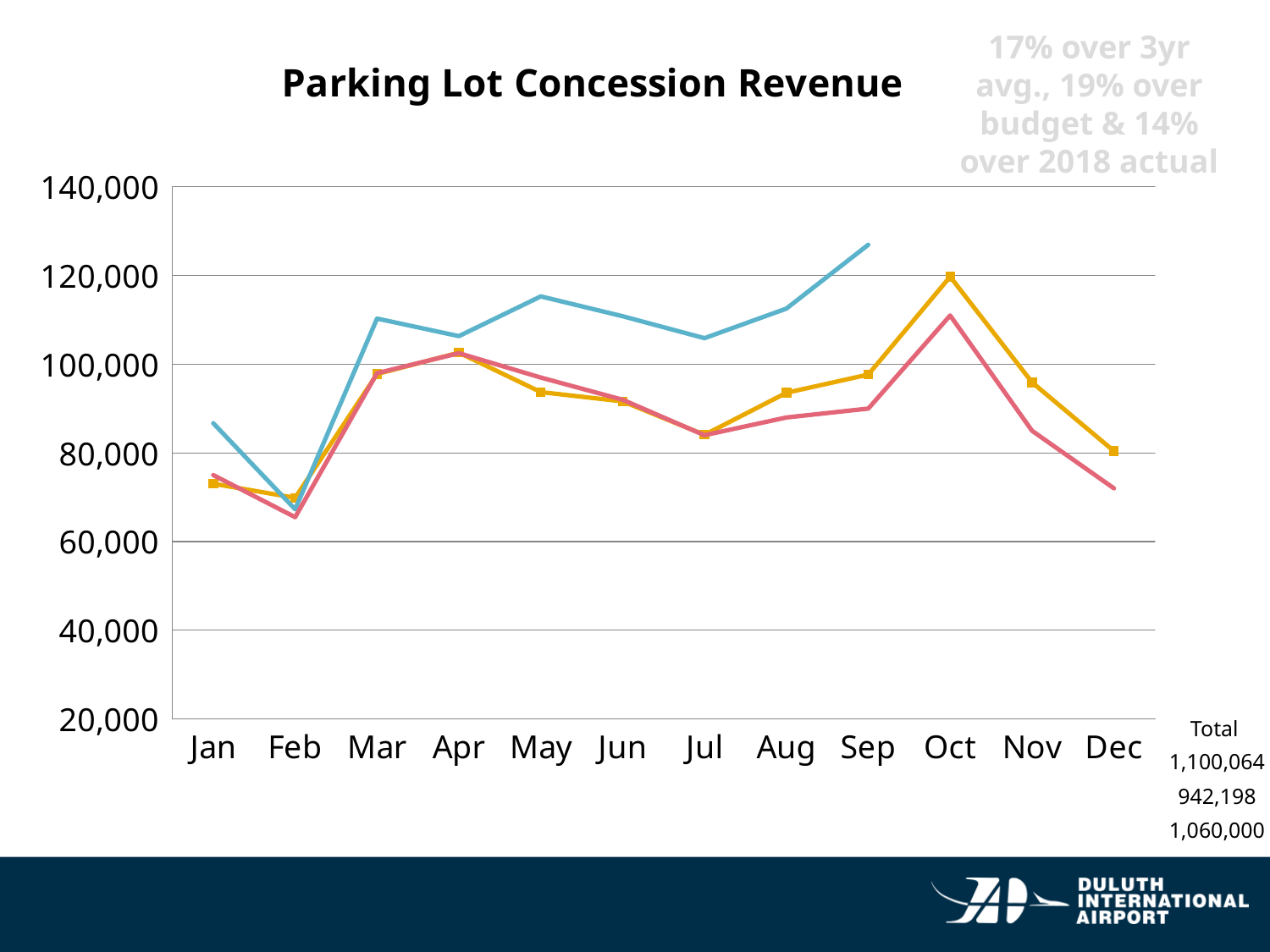
Is the value of the pink line in Dec greater or less than 80,000? less How many lines are plotted on the chart? 3 In which month does the yellow line reach its highest value? Oct What kind of chart is shown on the slide? line chart What is the title of the chart? Parking Lot Concession Revenue In which month does the blue line reach its highest value? Sep In Oct, which line has the higher value, the yellow line or the pink line? the yellow line Does the yellow line rise or fall from Oct to Dec? fall In which month does the pink line reach its lowest value? Feb How many months are shown on the x axis of the chart? 12 Is the value of the blue line in Sep greater or less than 120,000? greater Is the value of the yellow line in Jul greater or less than 100,000? less